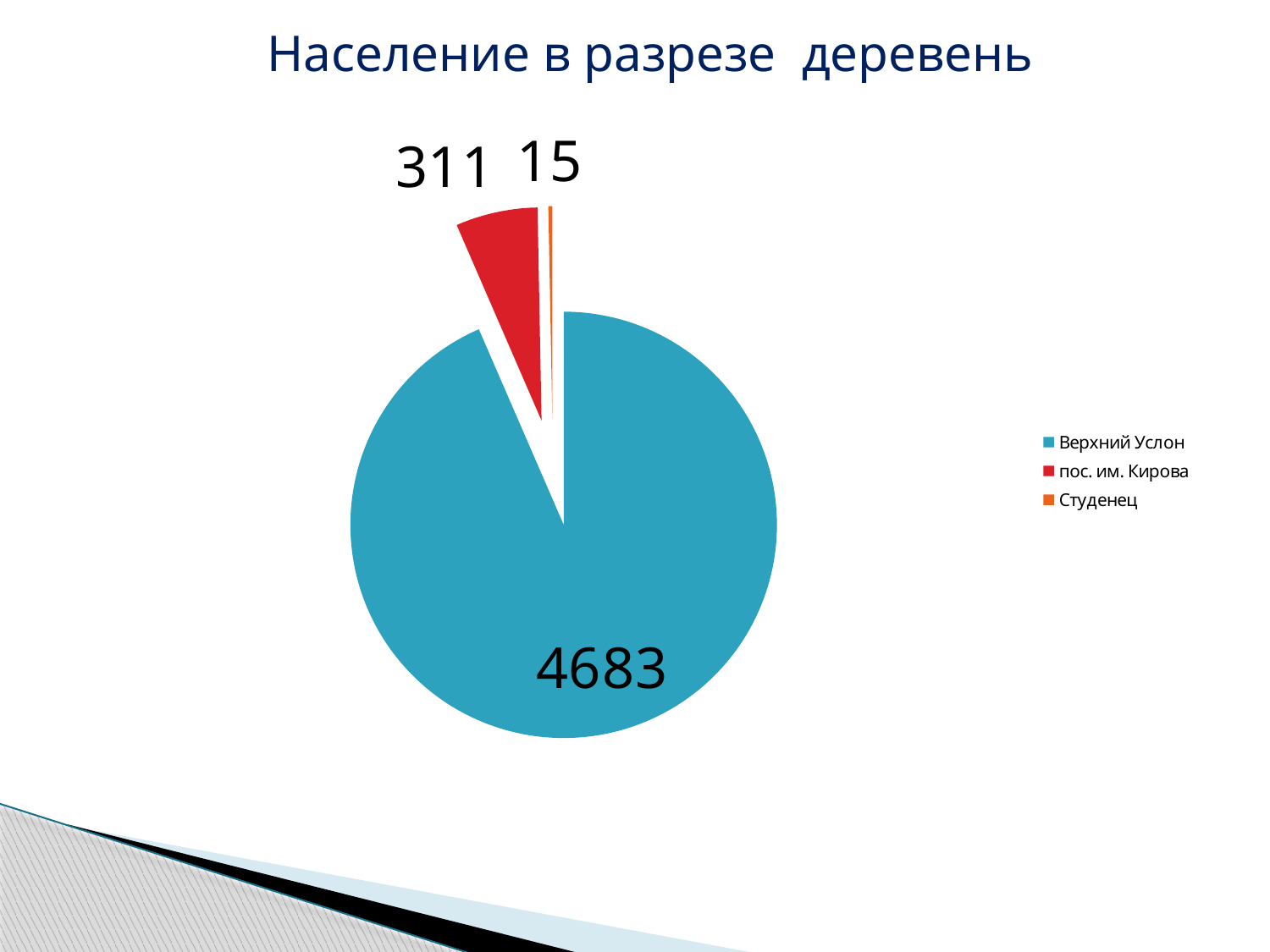
What is the title of the chart on the slide? Население в разрезе деревень What is the value shown for Студенец? 15 What is the difference between the values for пос. им. Кирова and Студенец? 296 What is the value shown for Верхний Услон? 4683 What is the total of all the values shown in the pie chart? 5009 What is the difference between the values for Верхний Услон and пос. им. Кирова? 4372 What kind of chart is shown on the slide? Pie chart Which category has the largest slice of the pie? Верхний Услон How many categories (slices) does the pie chart have? 3 Which is larger, the value for пос. им. Кирова or the value for Студенец? пос. им. Кирова Which category has the smallest slice of the pie? Студенец What is the value shown for пос. им. Кирова? 311